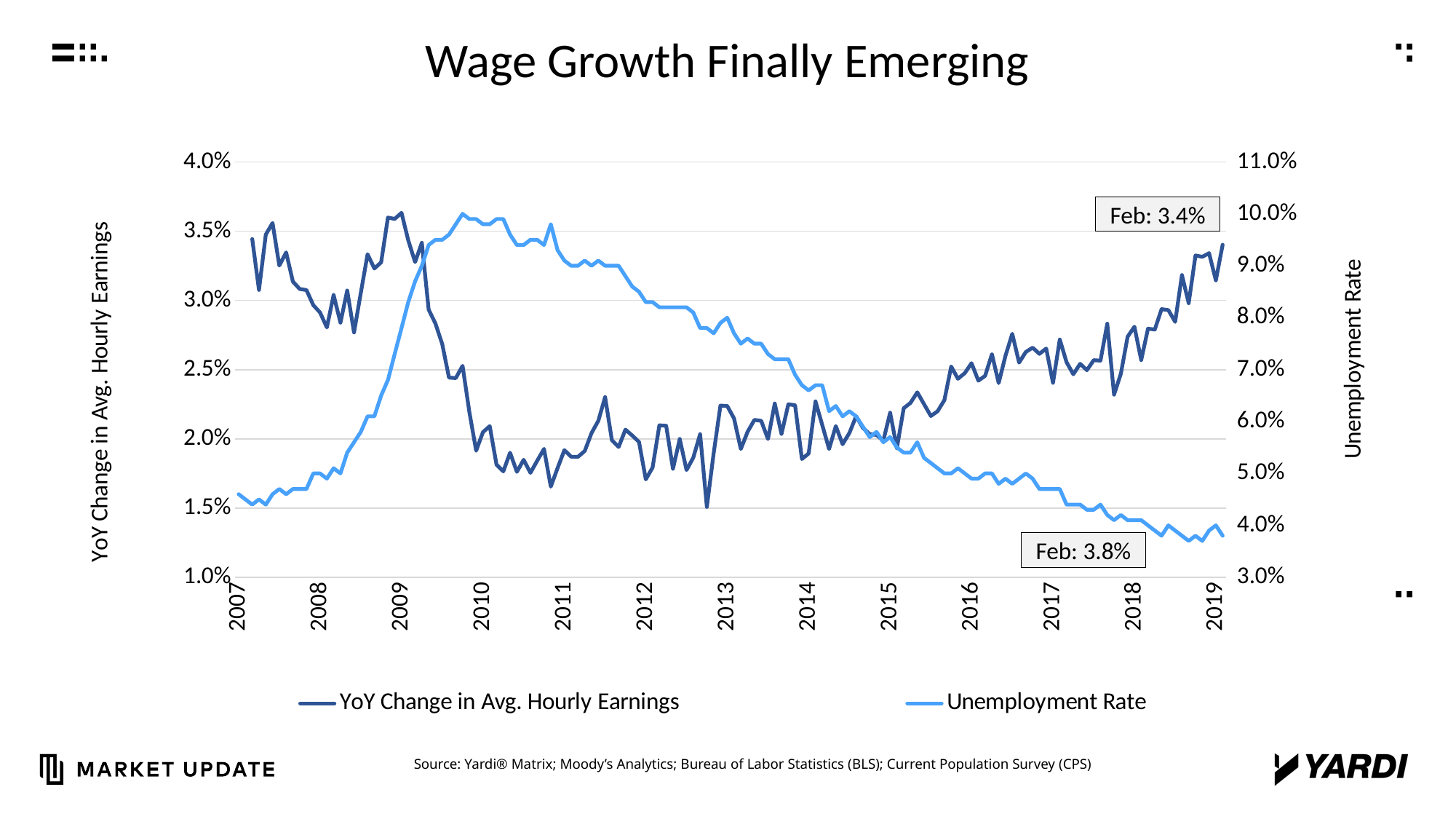
What kind of chart is shown on the slide? line chart Which is higher, the Unemployment Rate at the end of 2009 or at the start of 2019? end of 2009 What is the labelled February value for the Unemployment Rate at the end of the series? 3.8% Is the YoY Change in Avg. Hourly Earnings at the start of 2012 greater or less than 2.5%? less Does the Unemployment Rate rise or fall between 2010 and 2019? fall How many series does the legend list? 2 What is the title of the chart? Wage Growth Finally Emerging Is the Unemployment Rate at the start of 2007 greater or less than 5.0%? less What is the labelled February value for YoY Change in Avg. Hourly Earnings at the end of the series? 3.4% Does the YoY Change in Avg. Hourly Earnings rise or fall between 2013 and 2019? rise What is the label on the right-hand vertical axis? Unemployment Rate Is the Unemployment Rate at the start of 2010 greater or less than 9.0%? greater